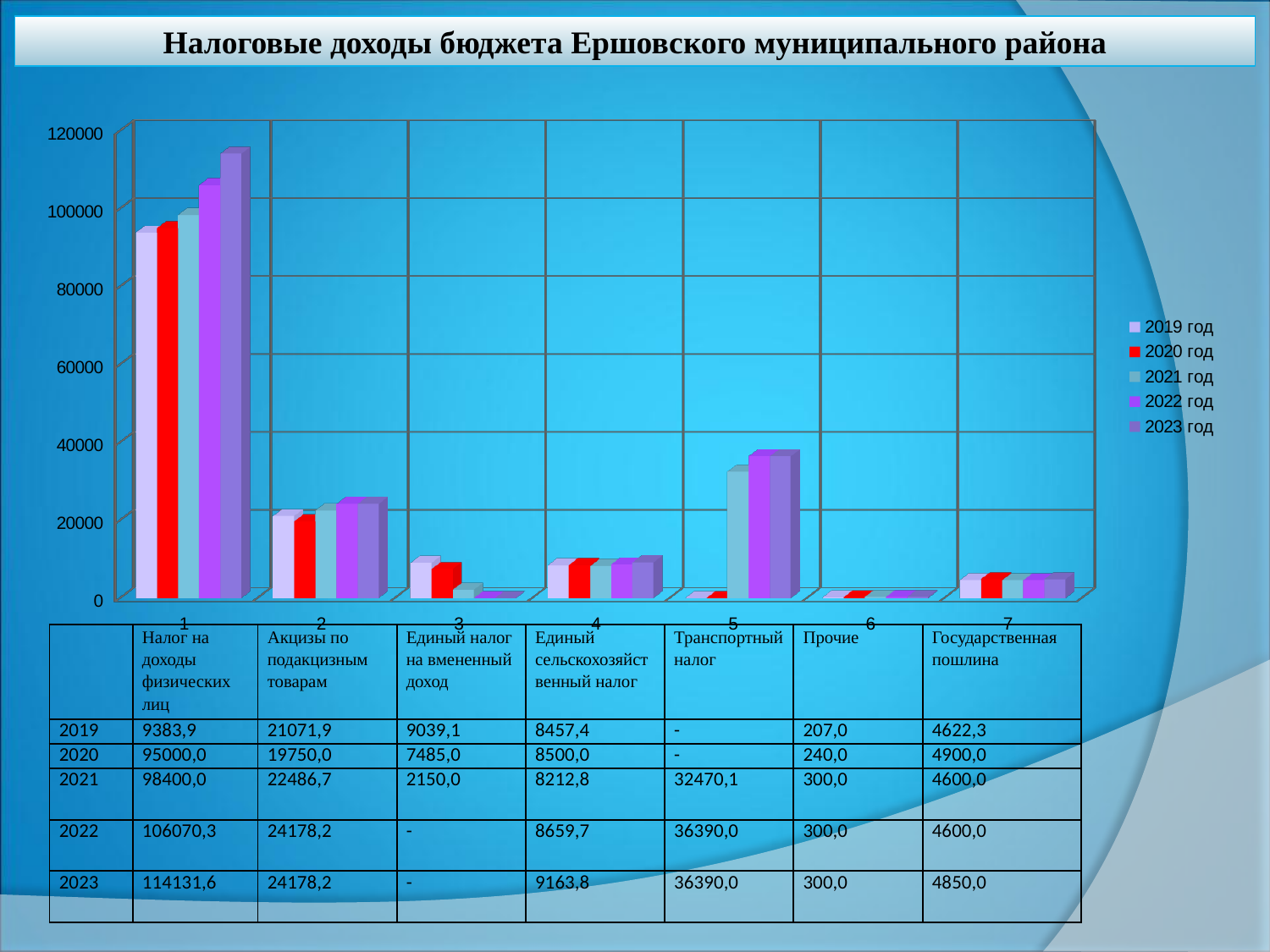
Which is larger for Транспортный налог: the 2021 value or the 2022 value? 2022 How many series does the chart legend list? 5 What is the 2021 value for Транспортный налог? 32470,1 Do the values for Налог на доходы физических лиц rise or fall from 2020 to 2023? rise Is the 2021 value for Транспортный налог greater or less than 20000? greater Which tax category has the highest bars in the chart? Налог на доходы физических лиц What is the difference between the 2023 and 2019 values for Единый сельскохозяйственный налог? 706,4 What is the difference between the 2023 and 2022 values for Налог на доходы физических лиц? 8061,3 How many tax categories are plotted along the x axis of the chart? 7 What type of chart is shown on the slide? bar chart What is the 2023 value for Налог на доходы физических лиц? 114131,6 What is the 2020 value for Государственная пошлина? 4900,0